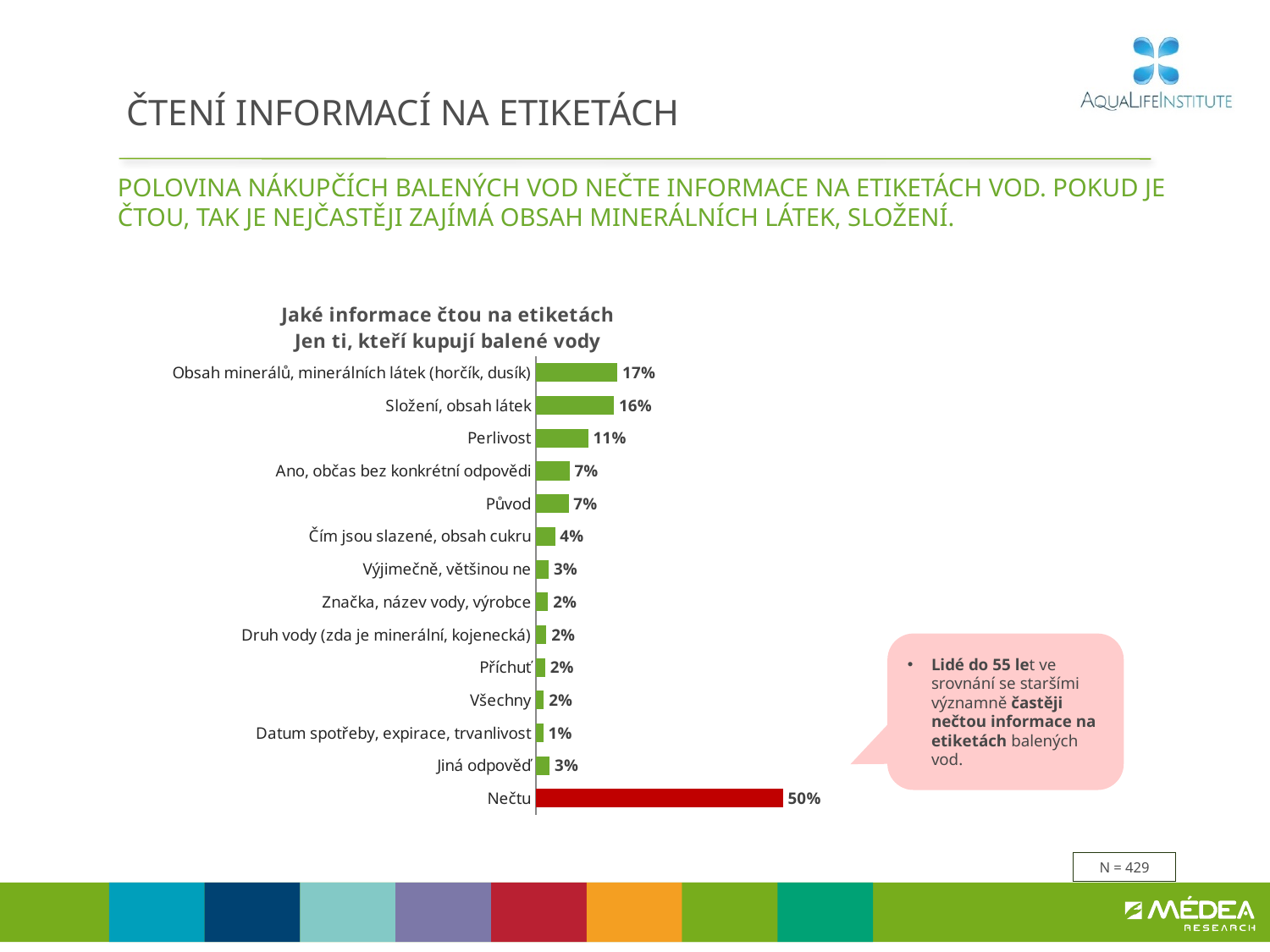
What is the value for "Nečtu"? 50% What colour is the bar for "Nečtu"? red What is the difference between the values for "Složení, obsah látek" and "Perlivost"? 5 percentage points What is the difference between the values for "Nečtu" and "Obsah minerálů, minerálních látek (horčík, dusík)"? 33 percentage points What is the value for "Perlivost"? 11% What is the value for "Datum spotřeby, expirace, trvanlivost"? 1% What is the value for "Obsah minerálů, minerálních látek (horčík, dusík)"? 17% Which category has the lowest value in the chart? Datum spotřeby, expirace, trvanlivost What type of chart is shown on the slide? bar chart How many categories are plotted in the chart? 14 Which is larger, the value for "Perlivost" or the value for "Čím jsou slazené, obsah cukru"? Perlivost Which category has the highest value in the chart? Nečtu